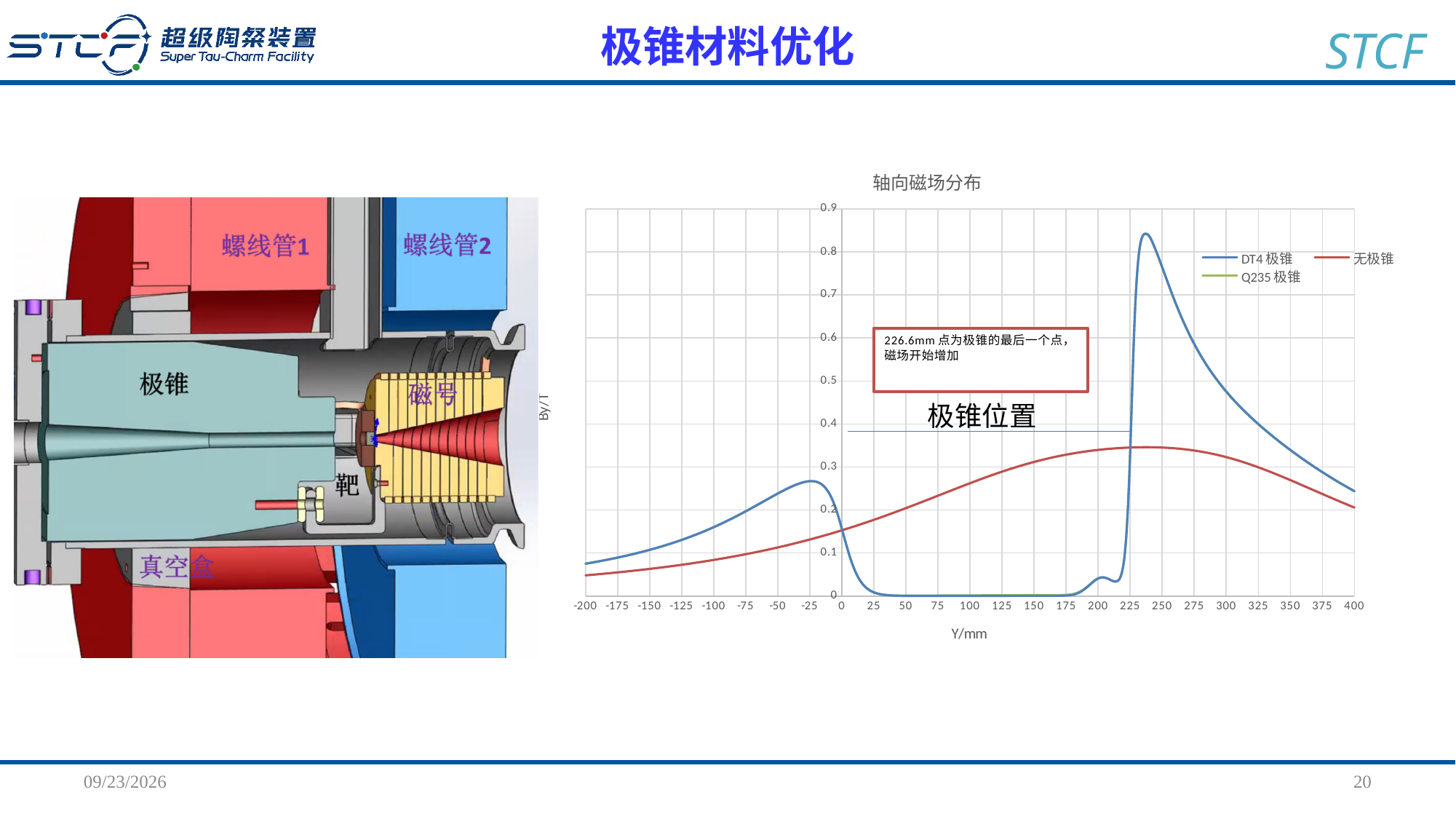
At Y = 100 mm, which series has the larger value, DT4 极锥 or 无极锥? 无极锥 What kind of chart is shown on the slide? line chart Does the 无极锥 series rise or fall as Y goes from -200 mm to 200 mm? rise At Y = 300 mm, which series has the larger value, DT4 极锥 or 无极锥? DT4 极锥 How many series does the legend of the chart list? 3 Which series reaches the highest peak value in the chart? DT4 极锥 Is the value of the DT4 极锥 series at Y = 250 mm greater or less than 0.7? greater What is the label of the x axis of the chart? Y/mm Is the value of the 无极锥 series at Y = -200 mm greater or less than 0.1? less Is the value of the 无极锥 series at Y = 250 mm greater or less than 0.4? less What is the title of the chart? 轴向磁场分布